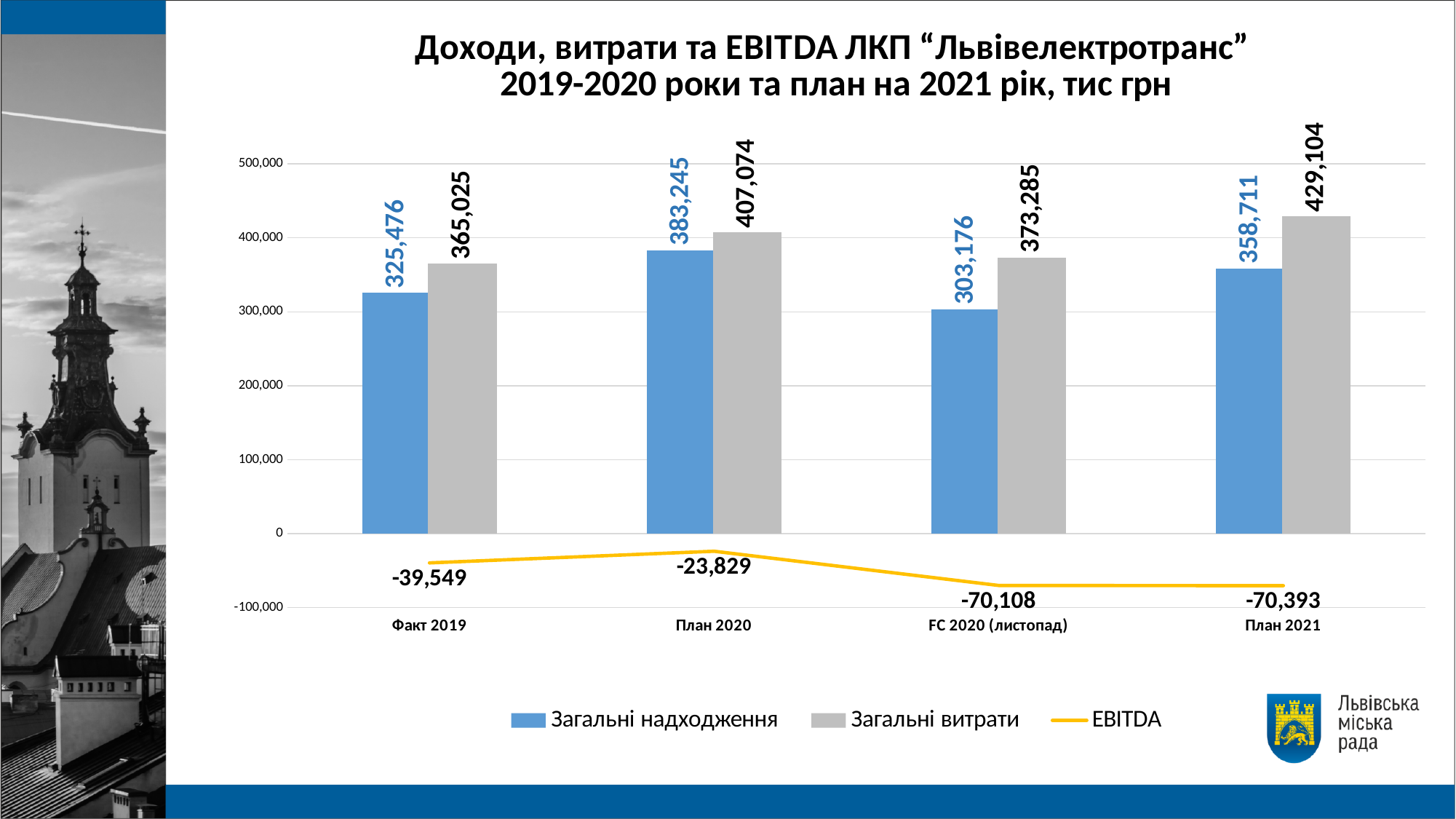
What is the value of Загальні надходження for Факт 2019? 325,476 How many series does the legend list? 3 What is the value of Загальні витрати for План 2021? 429,104 What is the difference between Загальні витрати and Загальні надходження for Факт 2019? 39,549 In which category is Загальні витрати the highest? План 2021 In which category is Загальні надходження the lowest? FC 2020 (листопад) What is the value of Загальні витрати for План 2020? 407,074 Which is larger for План 2020: Загальні надходження or Загальні витрати? Загальні витрати What colour is the EBITDA line? Yellow In which category is EBITDA the highest? План 2020 What is the EBITDA value for FC 2020 (листопад)? -70,108 How many categories are shown on the x axis? 4